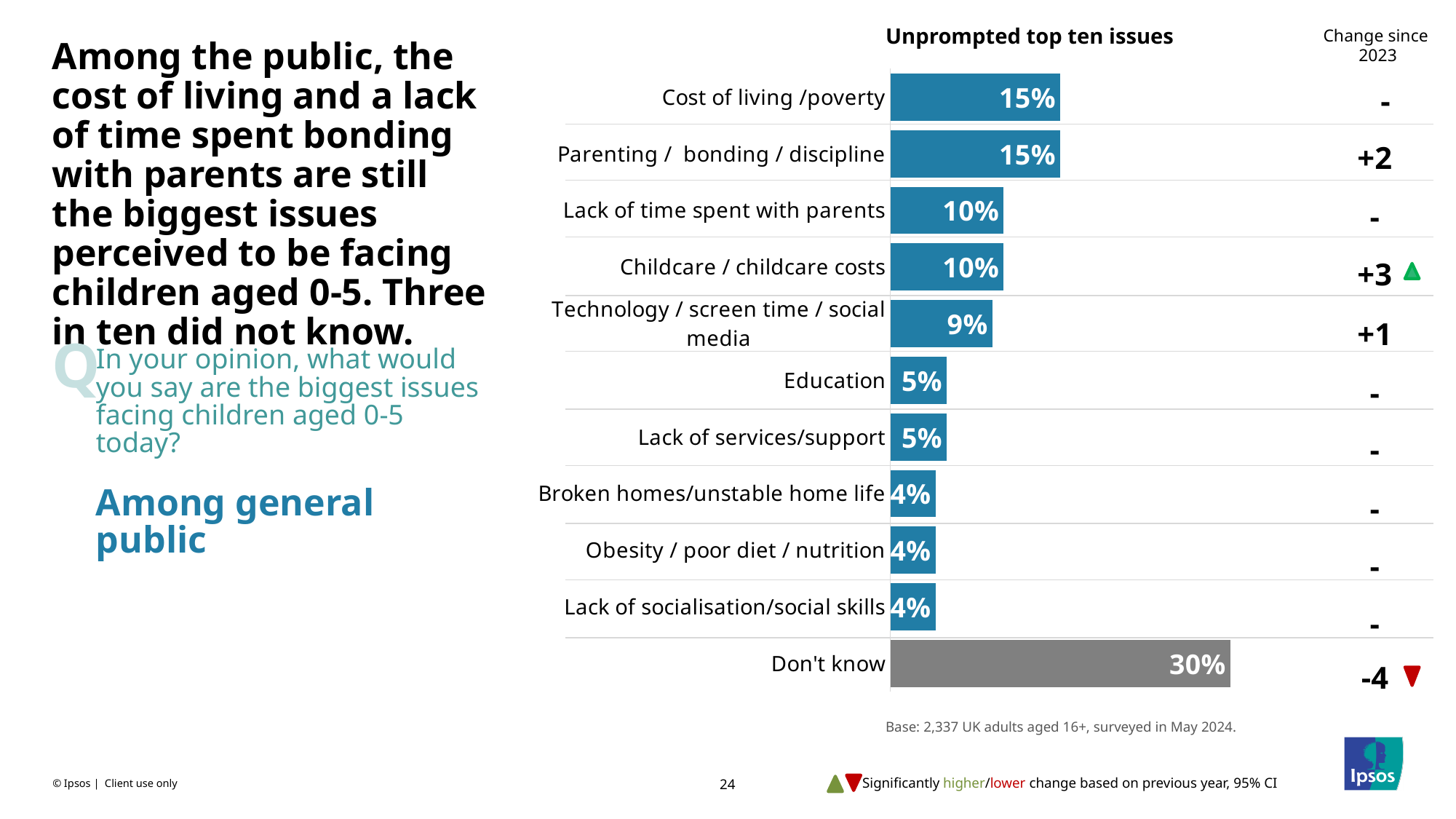
What is the change since 2023 shown for Childcare / childcare costs? +3 What percentage is shown for Technology / screen time / social media? 9% What percentage is shown for Cost of living /poverty? 15% What is the difference between the values for Parenting / bonding / discipline and Education? 10% What percentage is shown for Childcare / childcare costs? 10% How many categories are plotted in the chart? 11 What is the difference between the values for Don't know and Cost of living /poverty? 15% What is the title of the chart? Unprompted top ten issues Which is larger, the value for Lack of time spent with parents or the value for Lack of services/support? Lack of time spent with parents What kind of chart is shown on the slide? Bar chart Which category has the highest value in the chart? Don't know What percentage is shown for Don't know? 30%